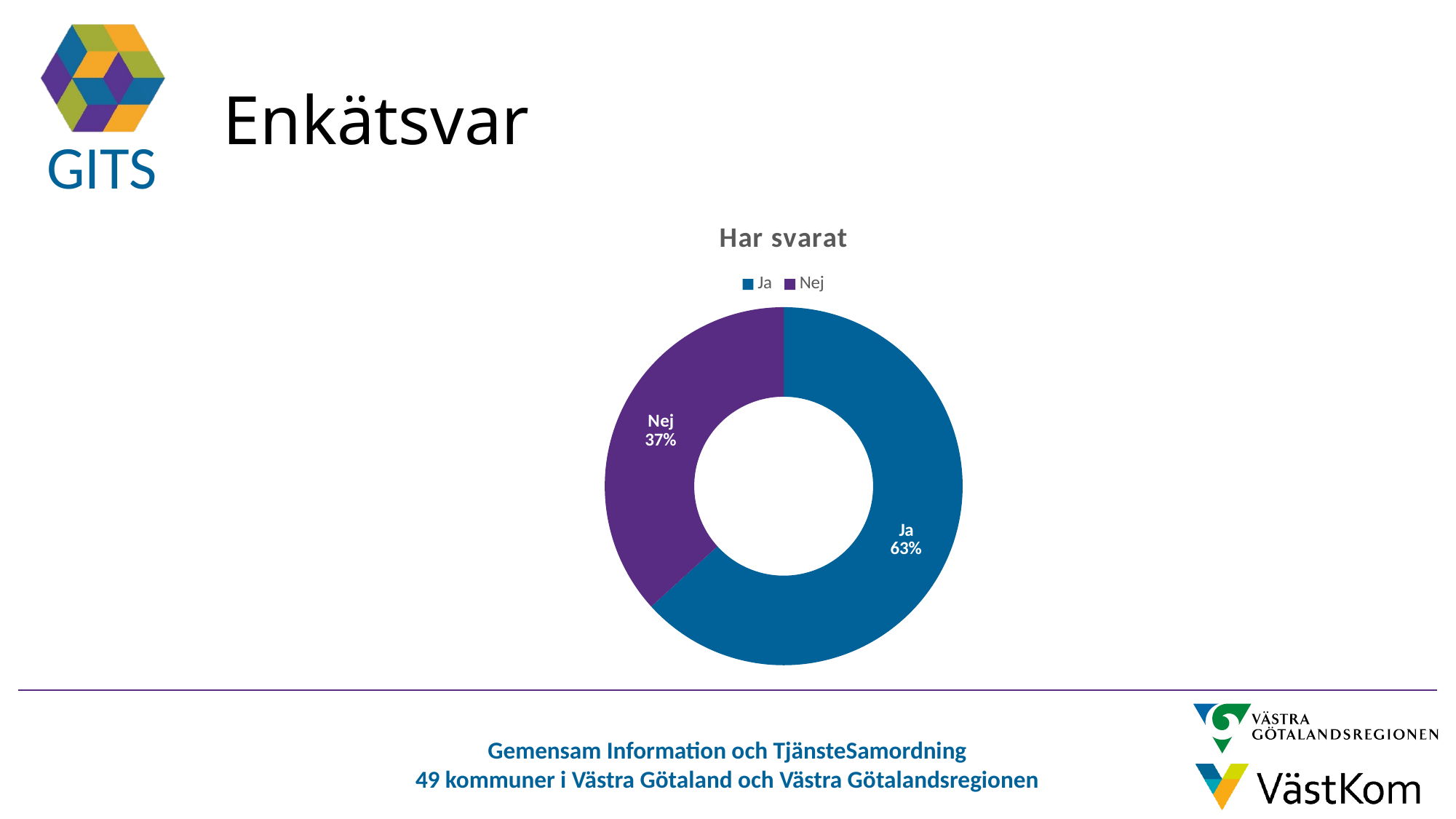
How many categories does the chart show? 2 Which category has the largest slice? Ja How many entries does the legend list? 2 Which category has the smallest slice? Nej What is the title of the chart? Har svarat What share of the chart does the "Nej" slice represent? 37% What kind of chart is shown on the slide? Doughnut (pie) chart What colour is the "Nej" slice? Purple Is the share for "Ja" greater or less than 50%? greater What is the difference in percentage points between the "Ja" and "Nej" slices? 26 percentage points What share of the chart does the "Ja" slice represent? 63% Which is larger, the "Ja" slice or the "Nej" slice? Ja